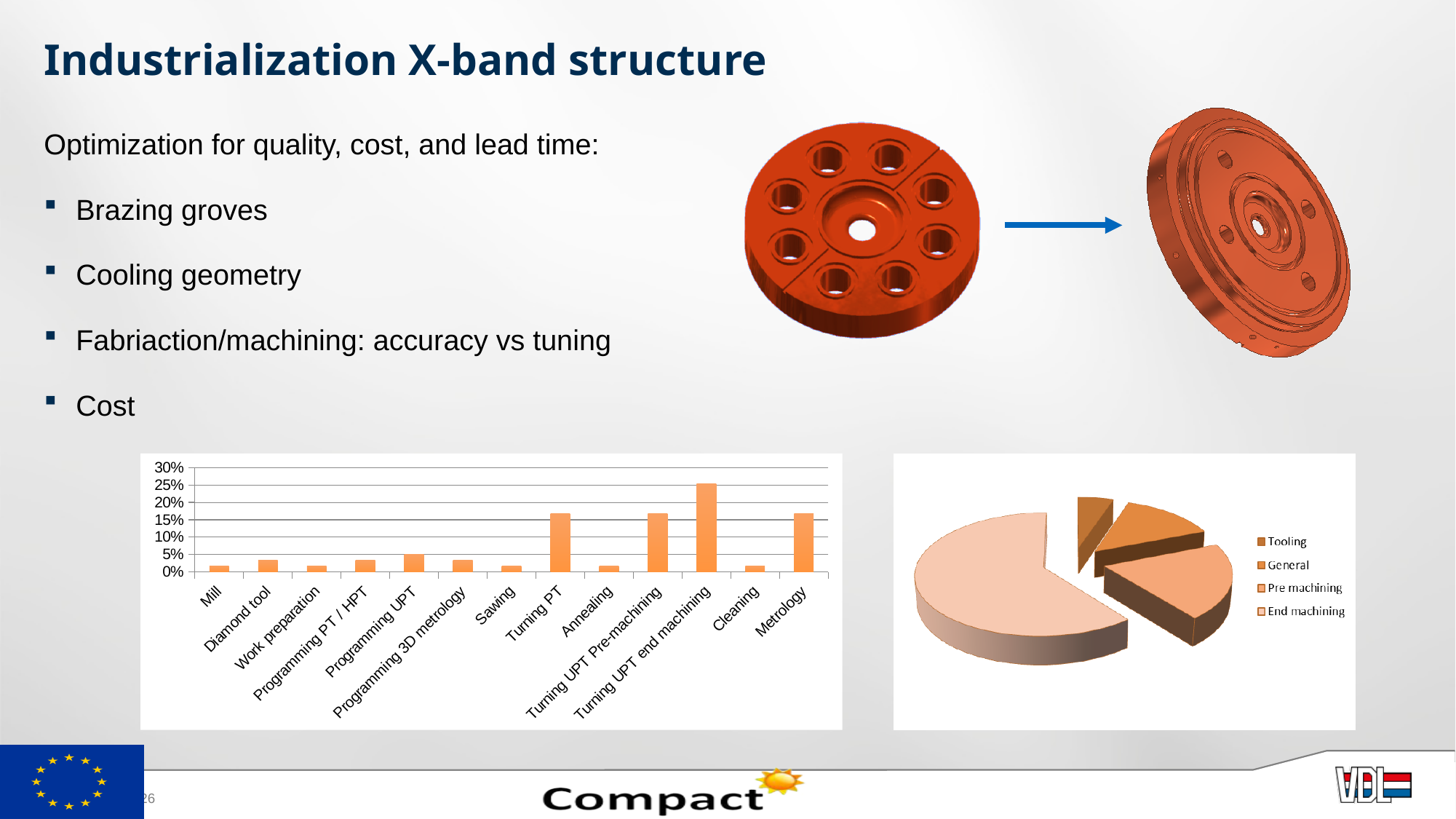
On the bar chart at the bottom left, which category has the highest value? Turning UPT end machining What kind of chart is the chart at the bottom left of the slide? bar chart What kind of chart is the chart at the bottom right of the slide? pie chart How many entries does the legend of the pie chart at the bottom right list? 4 How many categories are shown on the bar chart at the bottom left? 13 On the pie chart at the bottom right, which slice is the largest? End machining On the bar chart at the bottom left, which is larger: Turning UPT end machining or Turning UPT Pre-machining? Turning UPT end machining On the bar chart at the bottom left, which is larger: Mill or Programming UPT? Programming UPT On the bar chart at the bottom left, is the value for Turning PT greater or less than 10%? greater On the bar chart at the bottom left, is the value for Turning UPT end machining greater or less than 20%? greater On the bar chart at the bottom left, is the value for Programming 3D metrology greater or less than 10%? less